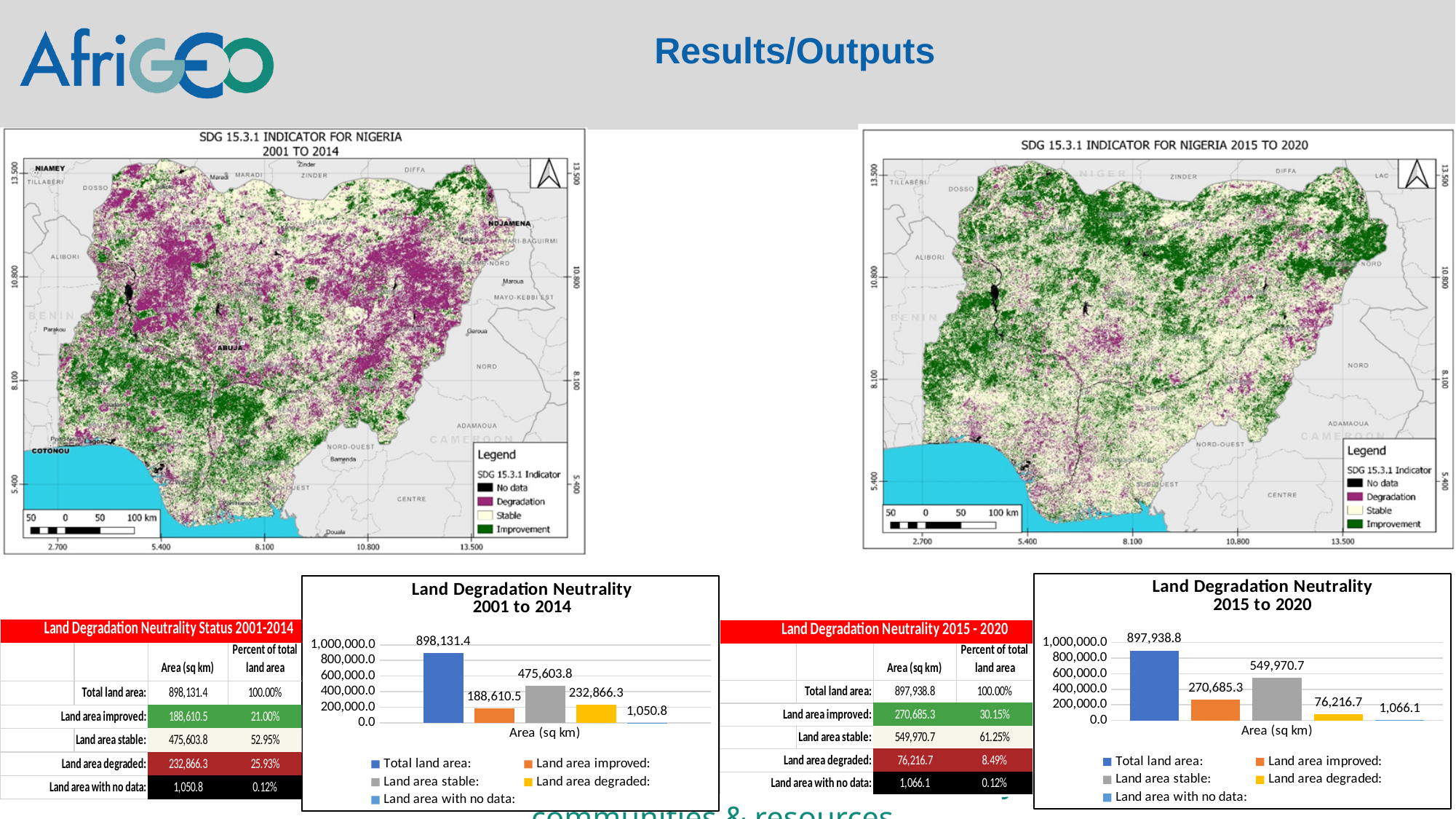
In the 'Land Degradation Neutrality 2015 to 2020' chart, what is the value for Land area improved? 270,685.3 In the 'Land Degradation Neutrality 2015 to 2020' chart, which is larger: Land area improved or Land area degraded? Land area improved How many series does the legend of the 'Land Degradation Neutrality 2015 to 2020' chart list? 5 In the 'Land Degradation Neutrality 2001 to 2014' chart, what is the difference between Land area degraded and Land area improved? 44,255.8 What kind of chart is the 'Land Degradation Neutrality 2001 to 2014' chart? Bar chart In the 'Land Degradation Neutrality 2015 to 2020' chart, which series has the highest value? Total land area In the 'Land Degradation Neutrality 2001 to 2014' chart, what is the value for Land area degraded? 232,866.3 In the 'Land Degradation Neutrality 2001 to 2014' chart, which series has the lowest value? Land area with no data In the 'Land Degradation Neutrality 2015 to 2020' chart, what is the difference between Land area stable and Land area improved? 279,285.4 In the 'Land Degradation Neutrality 2015 to 2020' chart, what is the value for Land area with no data? 1,066.1 In the 'Land Degradation Neutrality 2001 to 2014' chart, what is the value for Land area stable? 475,603.8 In the 'Land Degradation Neutrality 2001 to 2014' chart, is the value for Land area stable greater or less than 400,000.0? greater